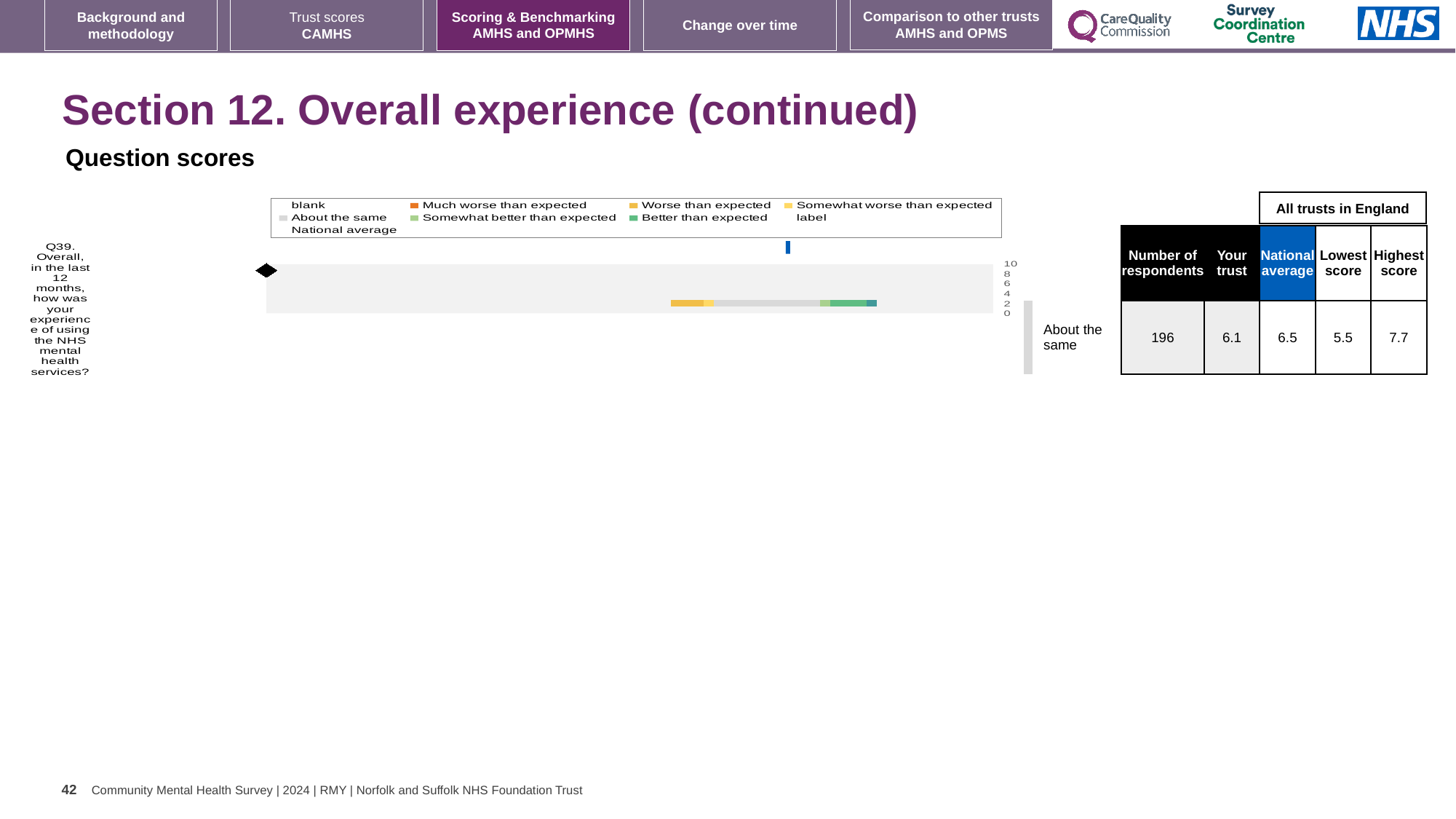
In the table beside the chart, how many respondents answered Q39? 196 In the table beside the chart, what is the highest score among all trusts in England for Q39? 7.7 How many question categories are plotted on the chart? 1 In the table beside the chart, what is the 'Your trust' score for Q39? 6.1 In the table beside the chart, what is the difference between the highest score and the lowest score for Q39? 2.2 How many entries does the chart's legend list? 9 What is the highest value shown on the chart's numeric axis? 10 In the table beside the chart, which is larger for Q39: the 'Your trust' score or the national average? National average What kind of chart is shown on the slide? bar chart In the table beside the chart, what is the lowest score among all trusts in England for Q39? 5.5 In the table beside the chart, what is the national average score for Q39? 6.5